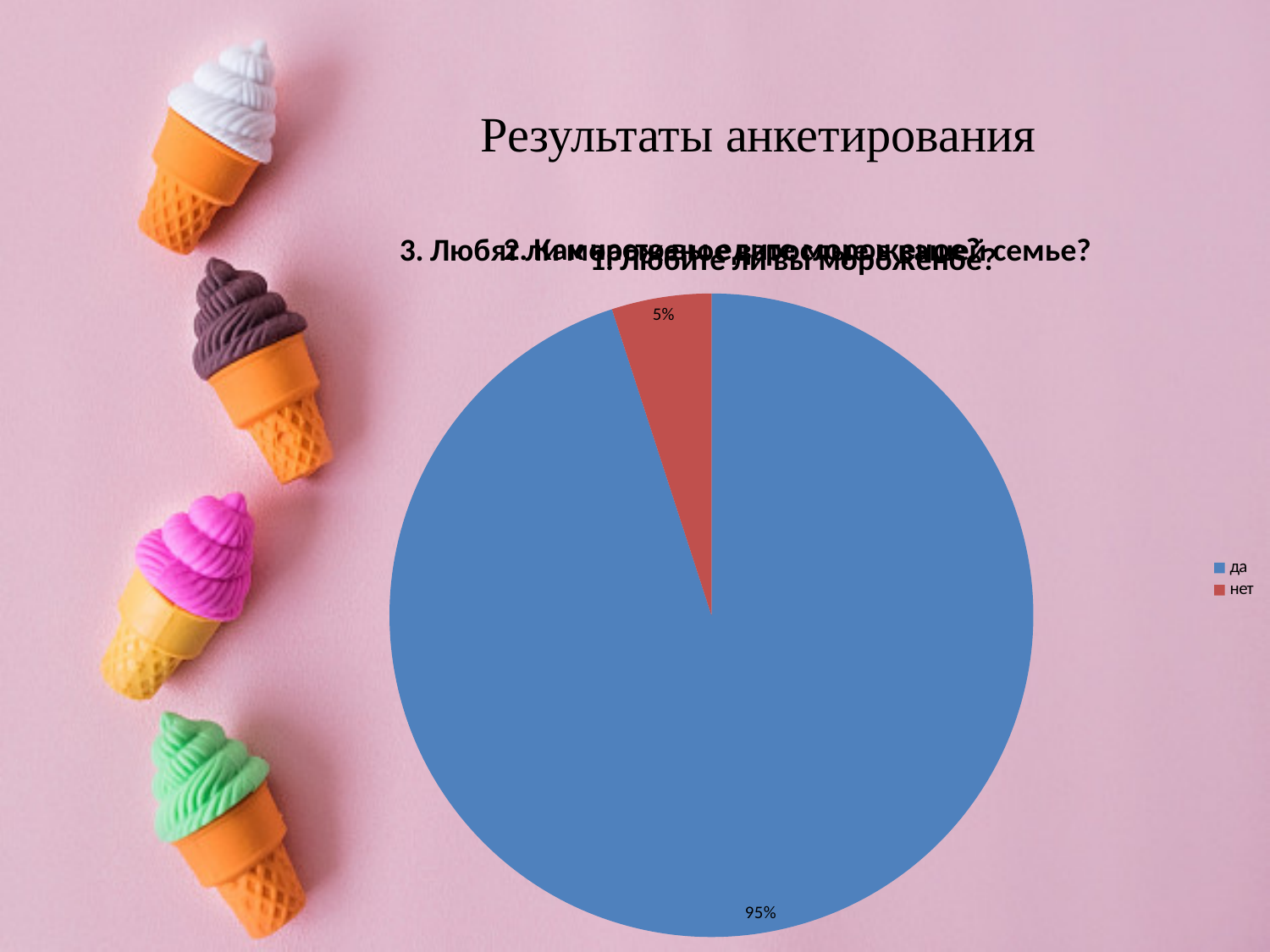
Which is larger, the share for "да" or the share for "нет"? да Which slice of the pie is the smallest? нет Which slice of the pie is the largest? да What share of the pie does "да" have? 95% What colour is the "нет" slice? red What is the difference between the shares for "да" and "нет"? 90% What share of the pie does "нет" have? 5% What kind of chart is shown on the slide? pie chart How many entries does the legend list? 2 How many slices does the pie chart have? 2 What colour is the "да" slice? blue